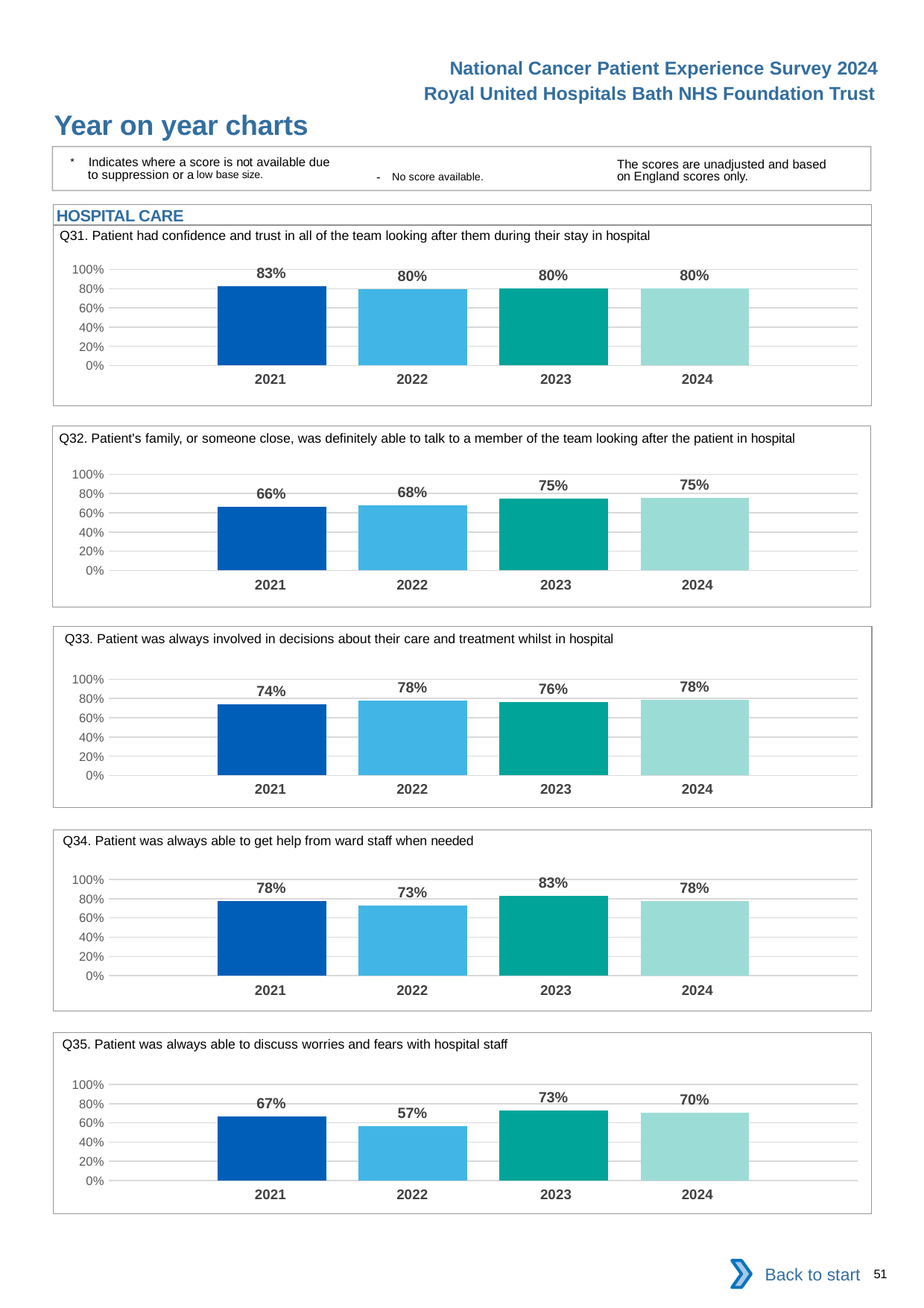
In the Q32 chart, do the values generally rise or fall from 2021 to 2024? rise In the Q32 chart, what is the difference between the 2024 value and the 2021 value? 9% In the Q34 chart, is the value for 2022 larger or smaller than the value for 2021? smaller In the Q35 chart, is the value for 2022 greater or less than 60%? less In the Q34 chart, which year has the highest value? 2023 In the Q33 chart, what is the value for 2023? 76% In the Q35 chart, what is the difference between the 2023 value and the 2022 value? 16% What kind of chart is the Q33 chart? bar chart In the Q32 chart, which year has the lowest value? 2021 How many years are shown in the Q31 chart? 4 In the Q35 chart, what is the value for 2022? 57% In the Q31 chart, what is the value for 2021? 83%